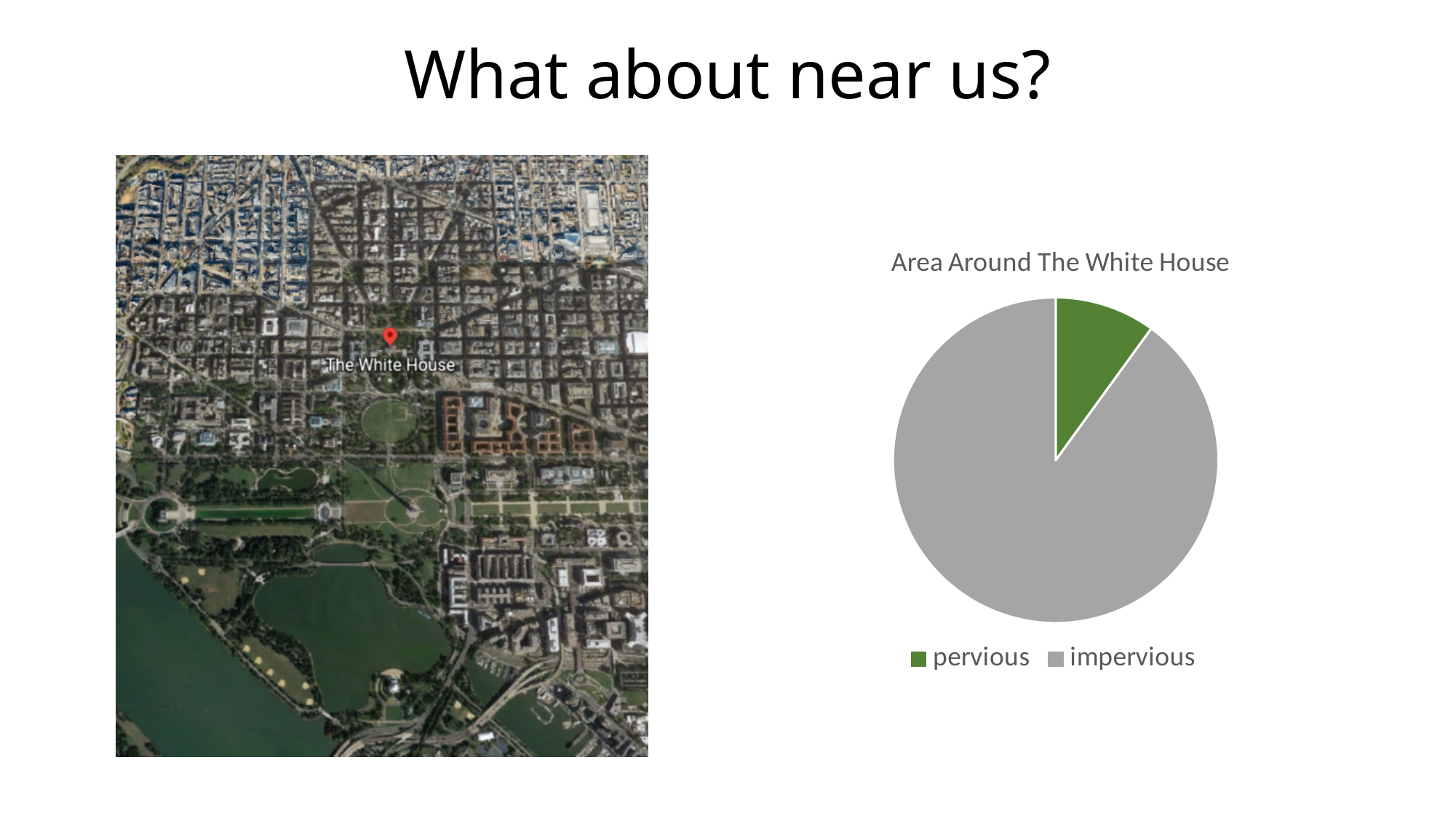
What colour is the pervious slice in the pie chart? green How many slices does the pie chart have? 2 Which slice is larger in the pie chart, pervious or impervious? impervious Which category has the smallest slice in the pie chart? pervious What is the title of the pie chart? Area Around The White House How many entries does the legend of the pie chart list? 2 What kind of chart is shown on the slide? pie chart Which category has the largest slice in the pie chart? impervious